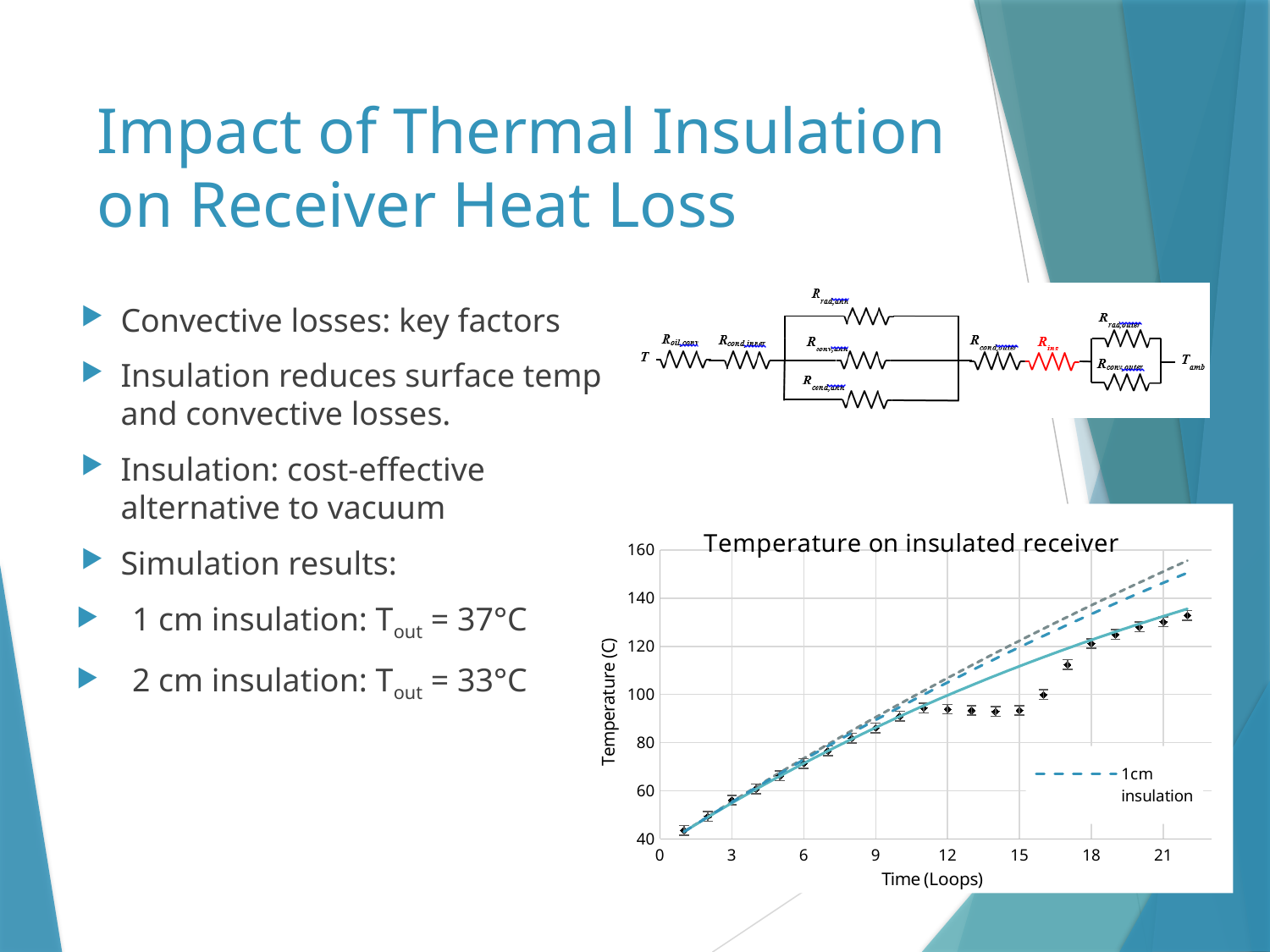
What is the highest value shown on the y axis of the chart? 160 Does the 1cm insulation line rise or fall as time (loops) increases? rises Is the value of the 1cm insulation line at 21 loops greater or less than 140? greater At 21 loops, which is higher: the 1cm insulation dashed line or the solid line? 1cm insulation dashed line What kind of chart is shown on the slide? line chart What series name is listed in the chart's legend? 1cm insulation What is the label of the x axis of the chart? Time (Loops) What is the title of the chart on the slide? Temperature on insulated receiver Is the measured data point (marker with error bar) at 15 loops greater or less than 100? less Is the measured data point (marker with error bar) at 9 loops greater or less than 60? greater